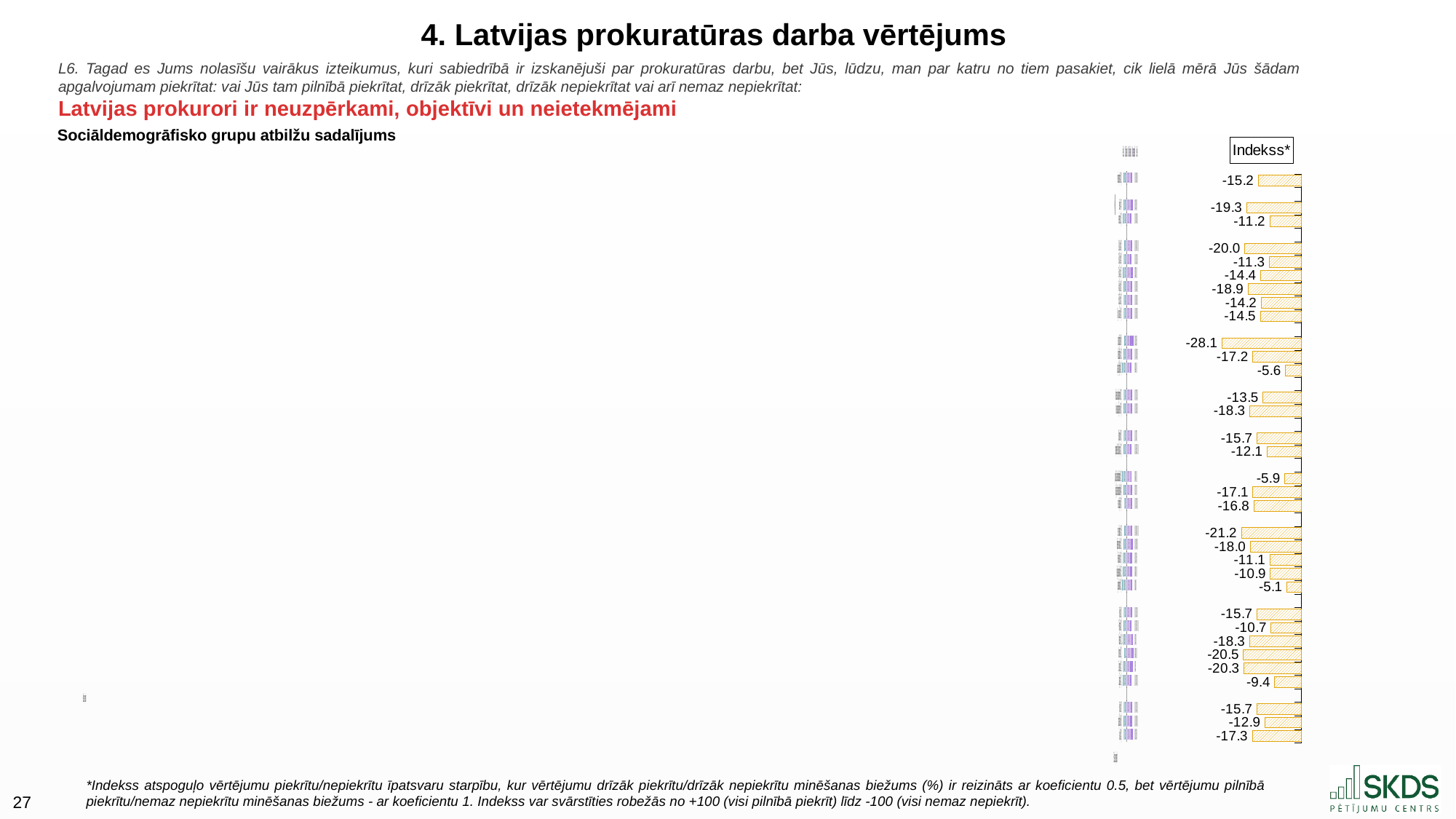
In the 'Indekss*' chart, what is the difference between the highest value (-5.1) and the lowest value (-28.1)? 23.0 In the 'Indekss*' chart, is the topmost bar's value greater or less than -20? greater In the 'Indekss*' chart, what is the lowest (most negative) value shown? -28.1 What kind of chart is the 'Indekss*' chart on the right side of the slide? bar chart In the 'Indekss*' chart, which is larger: the topmost bar (-15.2) or the bottommost bar (-17.3)? the topmost bar (-15.2) In the 'Indekss*' chart, is the lowest value greater or less than -20? less In the 'Indekss*' chart, what is the value of the topmost bar? -15.2 In the 'Indekss*' chart, what is the value of the bottommost bar? -17.3 In the 'Indekss*' chart, what is the highest (closest to zero) value shown? -5.1 In the 'Indekss*' chart, are all the plotted index values negative or positive? negative What is the title shown above the chart on the right side of the slide? Indekss*